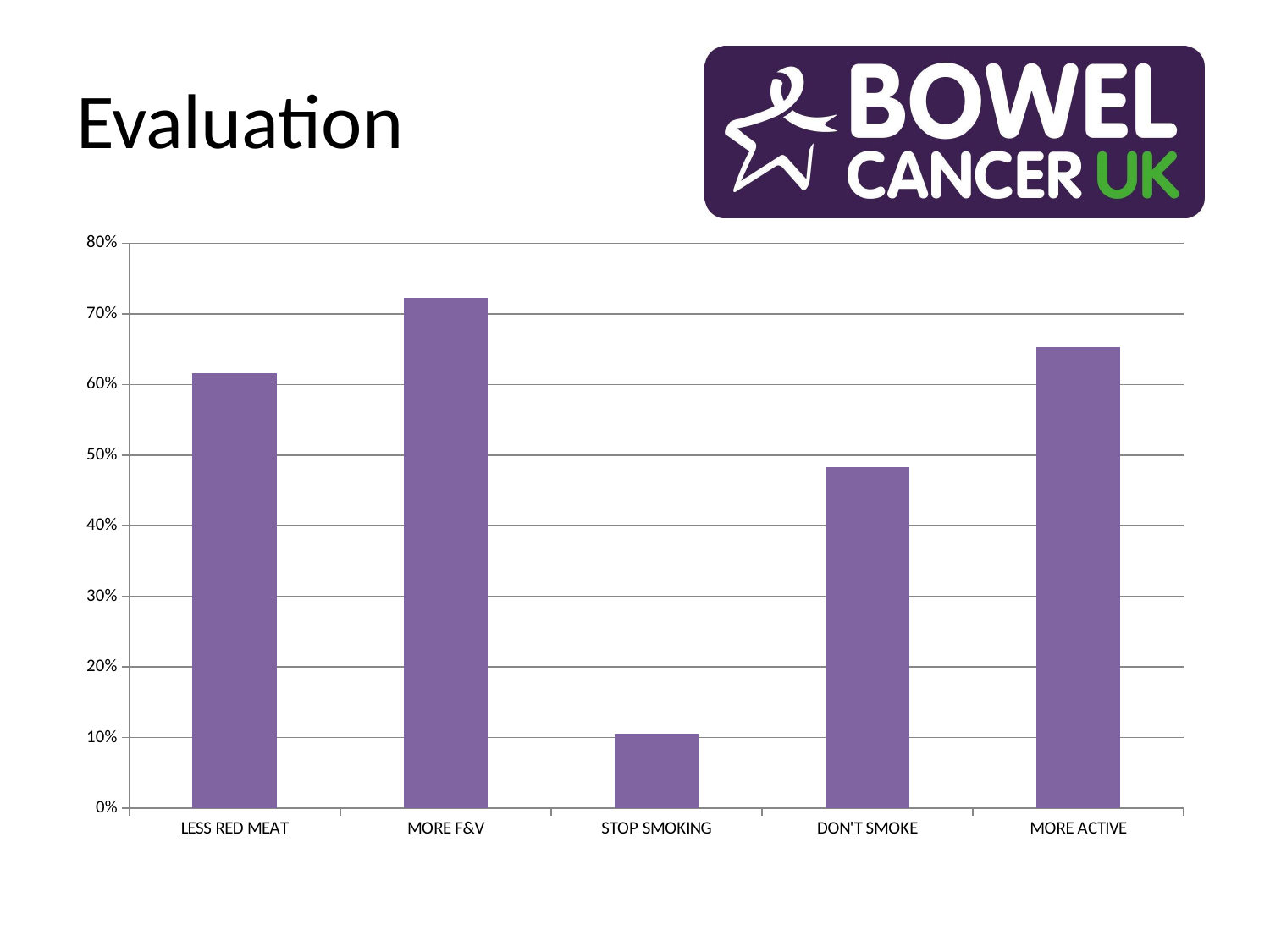
Is the value for MORE F&V greater or less than 70%? greater What kind of chart is shown on the slide? bar chart Which category has the highest value in the chart? MORE F&V Which is larger, the value for MORE ACTIVE or the value for LESS RED MEAT? MORE ACTIVE Is the value for STOP SMOKING greater or less than 20%? less Is the value for DON'T SMOKE greater or less than 50%? less How many categories are shown on the x axis of the chart? 5 What colour are the bars in the chart? purple Which category has the lowest value in the chart? STOP SMOKING Which is larger, the value for LESS RED MEAT or the value for DON'T SMOKE? LESS RED MEAT